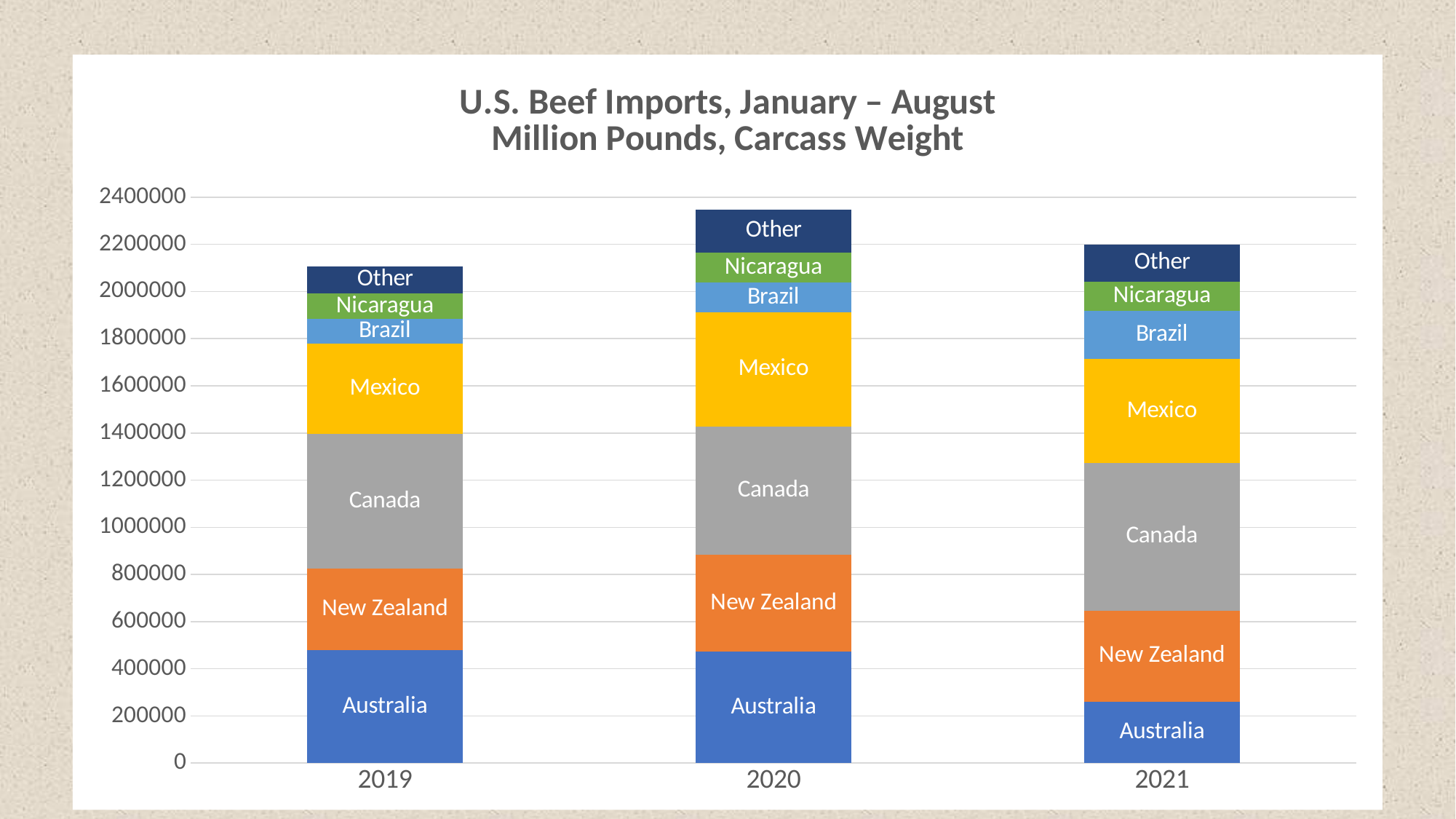
Is the Australia segment for 2021 greater or less than 400000? less Is the total for 2020 greater or less than 2200000? greater Is the Australia segment for 2019 greater or less than 400000? greater Which is larger, the Australia segment in 2019 or the Australia segment in 2021? 2019 Does the Australia segment rise or fall from 2019 to 2021? fall What is the title of the chart? U.S. Beef Imports, January – August Million Pounds, Carcass Weight How many segments (countries/regions) make up each stacked bar? 7 Which year has the highest total U.S. beef imports in the chart? 2020 Which year has the lowest total U.S. beef imports in the chart? 2019 What kind of chart is shown on the slide? stacked bar chart How many years are shown on the x axis of the chart? 3